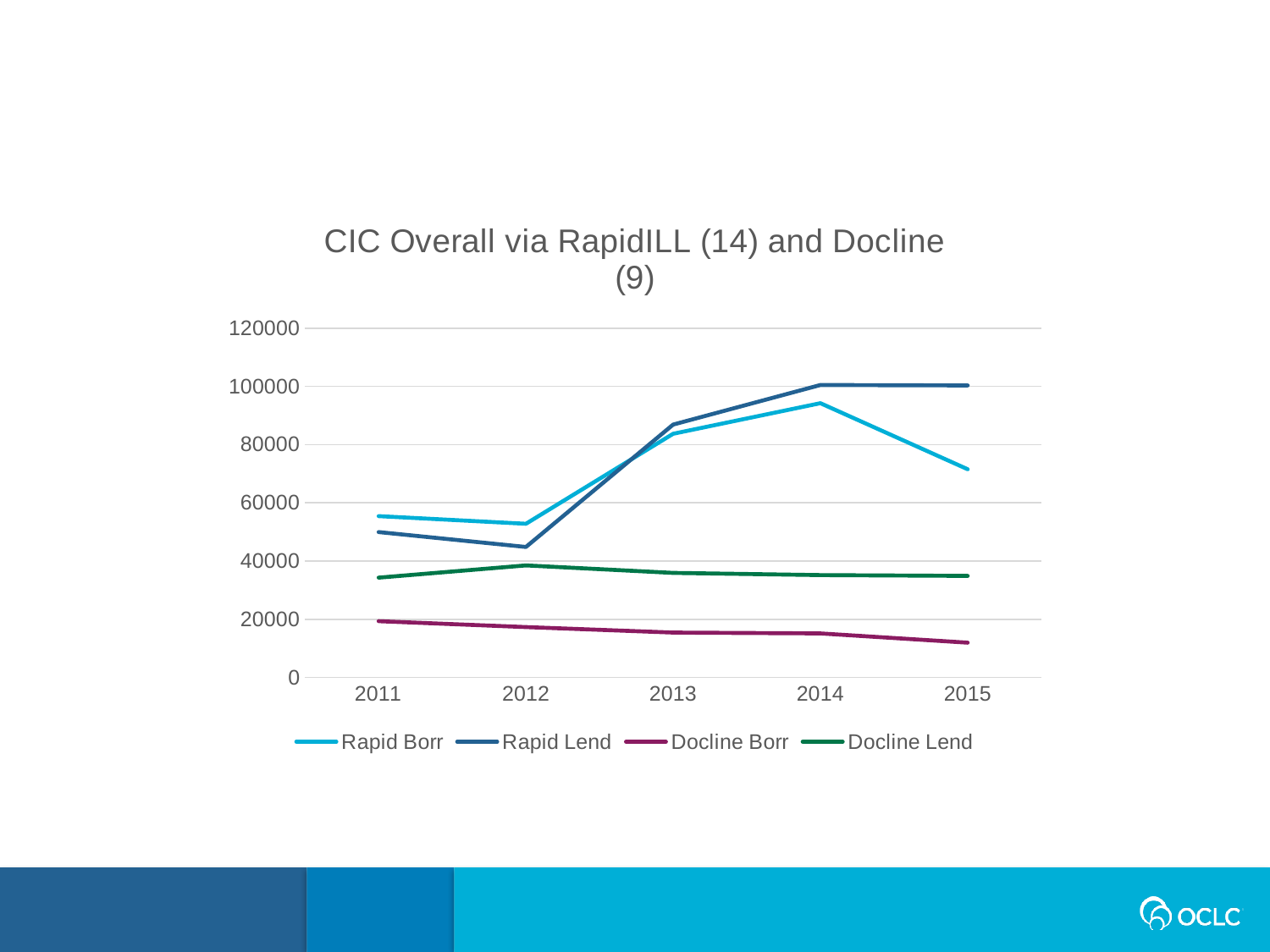
In 2015, which is larger: Rapid Lend or Rapid Borr? Rapid Lend What is the title of the chart? CIC Overall via RapidILL (14) and Docline (9) In 2013, which is larger: Docline Lend or Docline Borr? Docline Lend Is the value for Docline Borr in 2015 greater or less than 20000? less How many years are shown on the x axis? 5 How many series does the legend list? 4 In which year is Rapid Borr at its highest? 2014 In which year is Rapid Lend at its lowest? 2012 Is the value for Rapid Borr in 2011 greater or less than 40000? greater What kind of chart is shown on the slide? line chart Does the Docline Borr line rise or fall from 2011 to 2015? fall Is the value for Rapid Lend in 2014 greater or less than 80000? greater